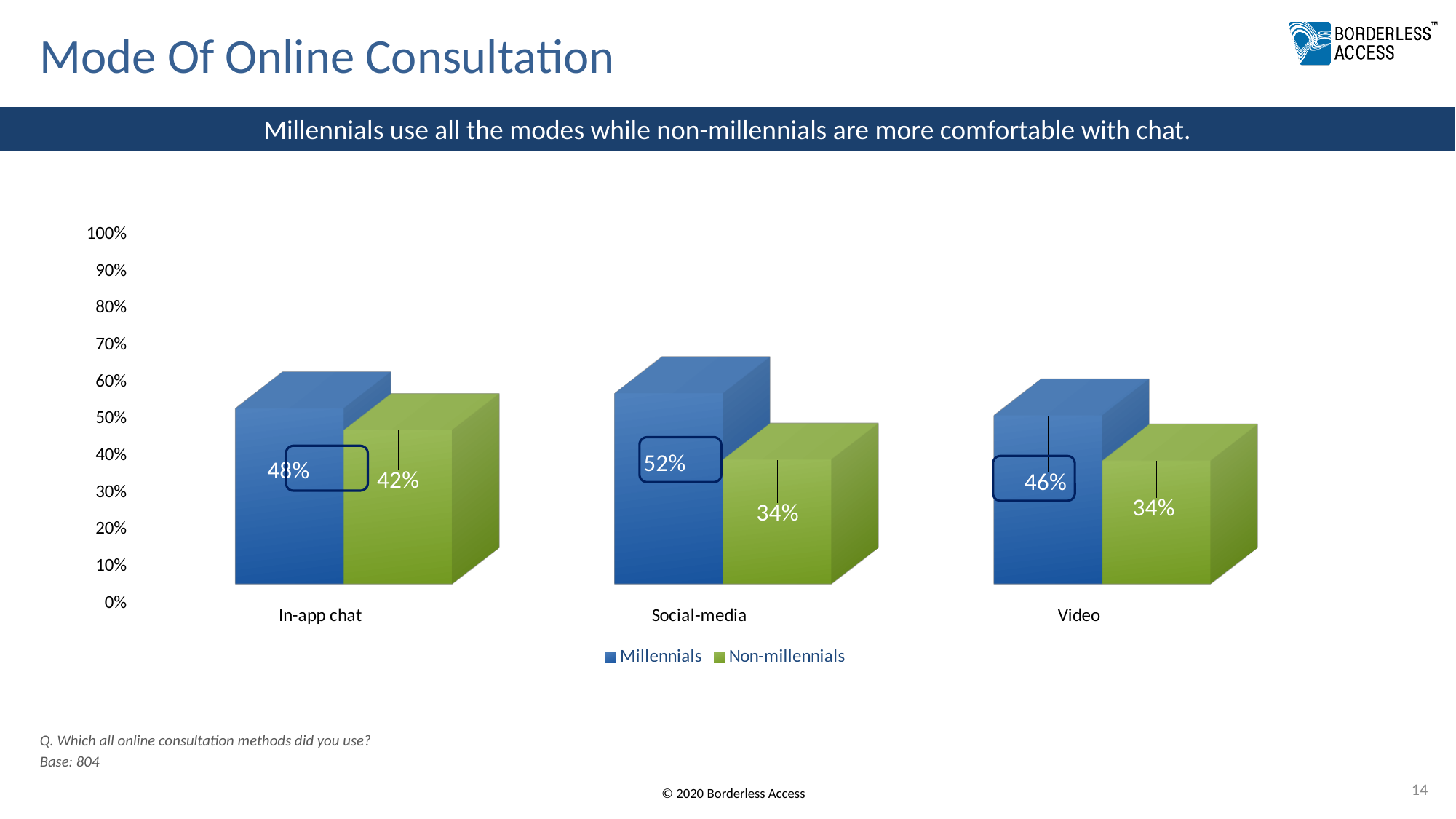
How many series does the legend list? 2 What is the value for Non-millennials for Social-media? 34% Which category has the highest value for Non-millennials? In-app chat What kind of chart is shown on the slide? Bar chart Which is larger for In-app chat, Millennials or Non-millennials? Millennials What is the value for Non-millennials for In-app chat? 42% What is the value for Millennials for In-app chat? 48% What is the difference between Millennials and Non-millennials for Social-media? 18% What is the difference between Millennials and Non-millennials for Video? 12% What is the value for Millennials for Video? 46% How many categories are shown on the x axis? 3 Which category has the highest value for Millennials? Social-media